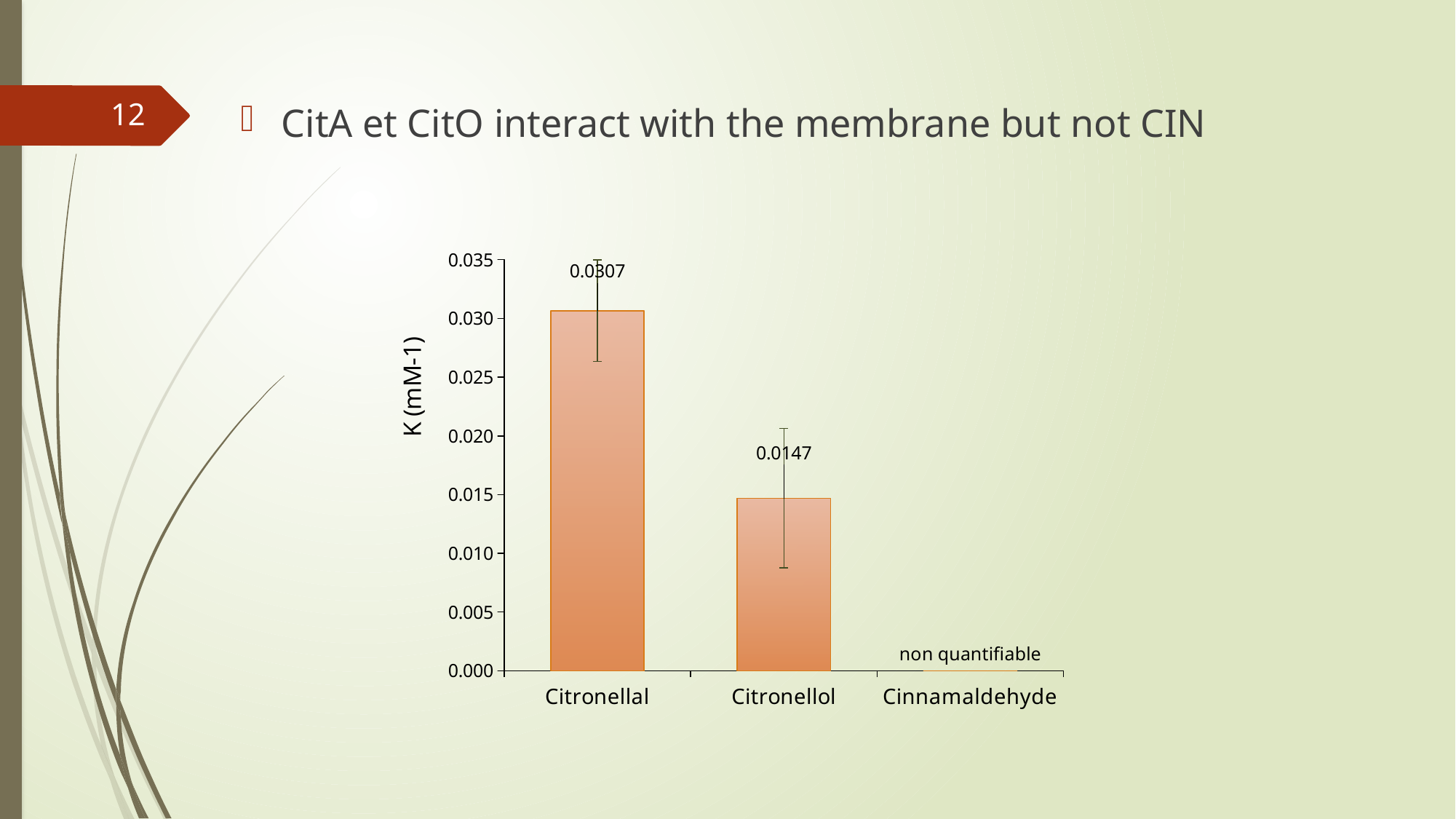
What is the K (mM-1) value for Citronellal? 0.0307 Is the value for Citronellal greater or less than 0.025? greater How many categories are shown on the x axis? 3 What is the K (mM-1) value for Citronellol? 0.0147 Which category has the highest K (mM-1) value? Citronellal What kind of chart is shown on the slide? bar chart What is the maximum value shown on the y axis? 0.035 What is the difference between the K values for Citronellal and Citronellol? 0.0160 What is the label of the y axis? K (mM-1) What is shown for Cinnamaldehyde instead of a bar value? non quantifiable Which has a larger K value, Citronellal or Citronellol? Citronellal Is the value for Citronellol greater or less than 0.020? less